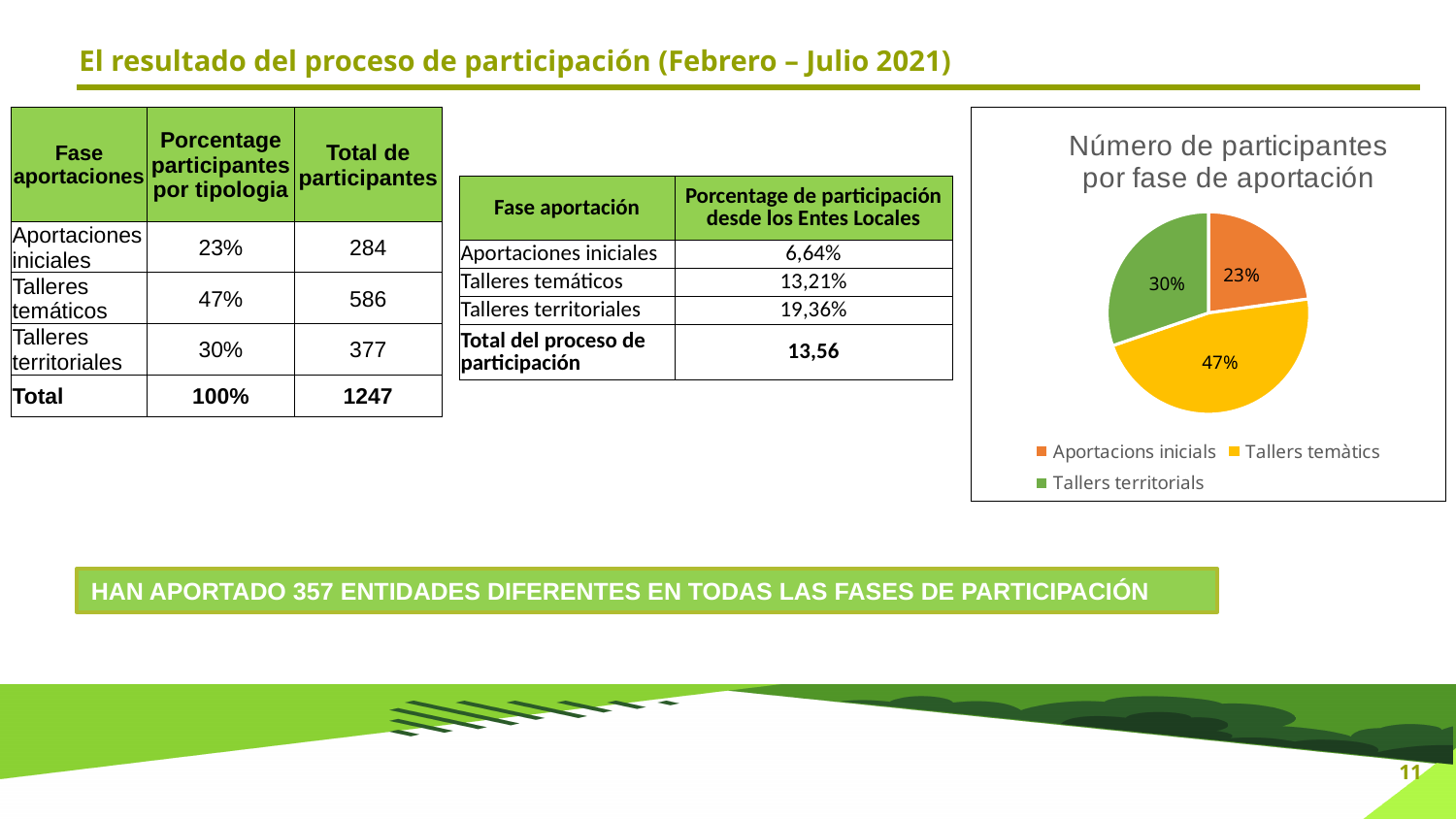
What colour is the Tallers temàtics slice in the pie chart? yellow How many slices does the pie chart have? 3 What is the title of the pie chart? Número de participantes por fase de aportación What share of the pie chart does Tallers territorials represent? 30% What kind of chart is shown on the slide? pie chart In the pie chart, which is larger: Tallers territorials or Aportacions inicials? Tallers territorials Which slice of the pie chart is the smallest? Aportacions inicials What share of the pie chart does Tallers temàtics represent? 47% How many entries does the pie chart's legend list? 3 Which slice of the pie chart is the largest? Tallers temàtics What share of the pie chart does Aportacions inicials represent? 23% In the pie chart, what is the difference in percentage points between Tallers temàtics and Tallers territorials? 17